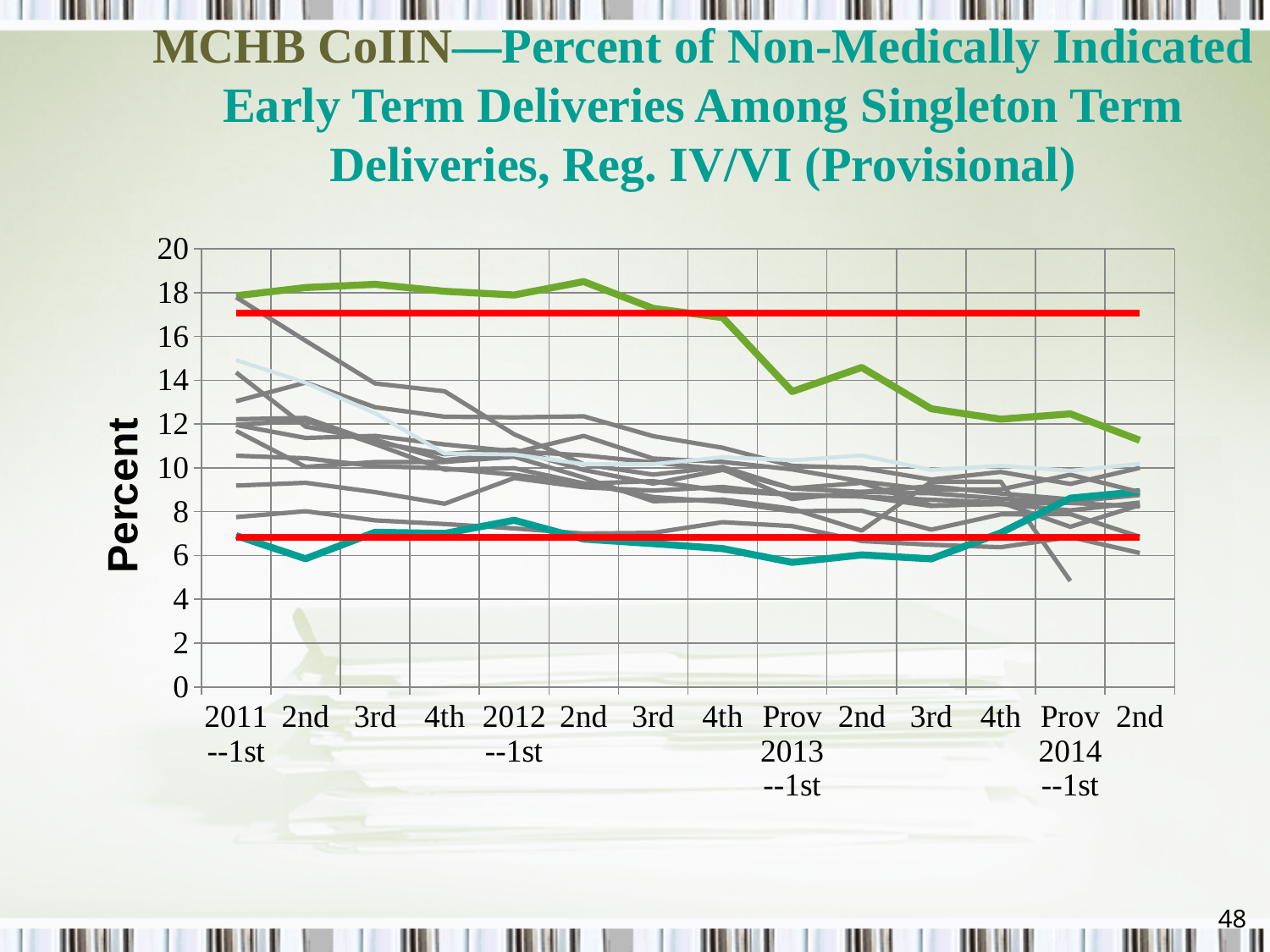
Does the thick green line rise or fall from 2011--1st to 2nd 2014? fall Is the upper red horizontal line above or below 16 on the y axis? above Is the value of the thick teal line at 2nd 2013 greater or less than 8? less Is the value of the thick green line at 2011--1st greater or less than 16? greater At 2011--1st, which is larger: the thick green line or the thick teal line? the thick green line How many points are labelled along the x axis of the chart? 14 What is the label on the y axis of the chart? Percent What kind of chart is shown on the slide? line chart What is the highest value shown on the y axis of the chart? 20